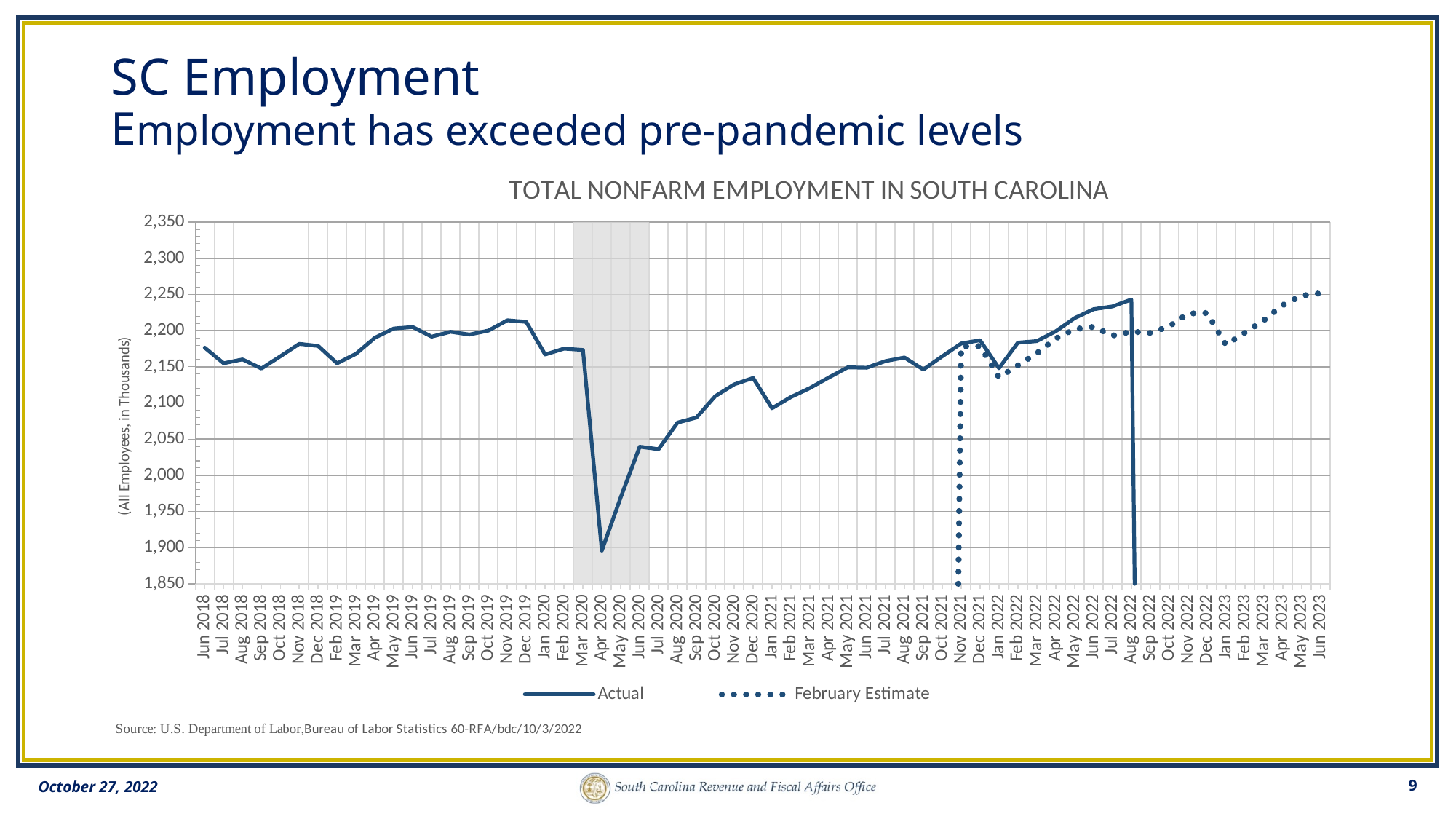
What is the title of the chart? TOTAL NONFARM EMPLOYMENT IN SOUTH CAROLINA In which month does the Actual series reach its lowest value? Apr 2020 In which month does the Actual series reach its highest value? Aug 2022 For Aug 2022, which is larger: the Actual value or the February Estimate value? Actual What kind of chart is shown on the slide? Line chart Is the February Estimate value for Jan 2023 greater or less than 2,200? less Is the Actual value for Aug 2022 greater or less than 2,200? greater How many series does the legend list? 2 Is the Actual value for Apr 2020 greater or less than 1,950? less Does the Actual series generally rise or fall from Apr 2020 to Aug 2022? Rise What are the two series named in the legend? Actual and February Estimate